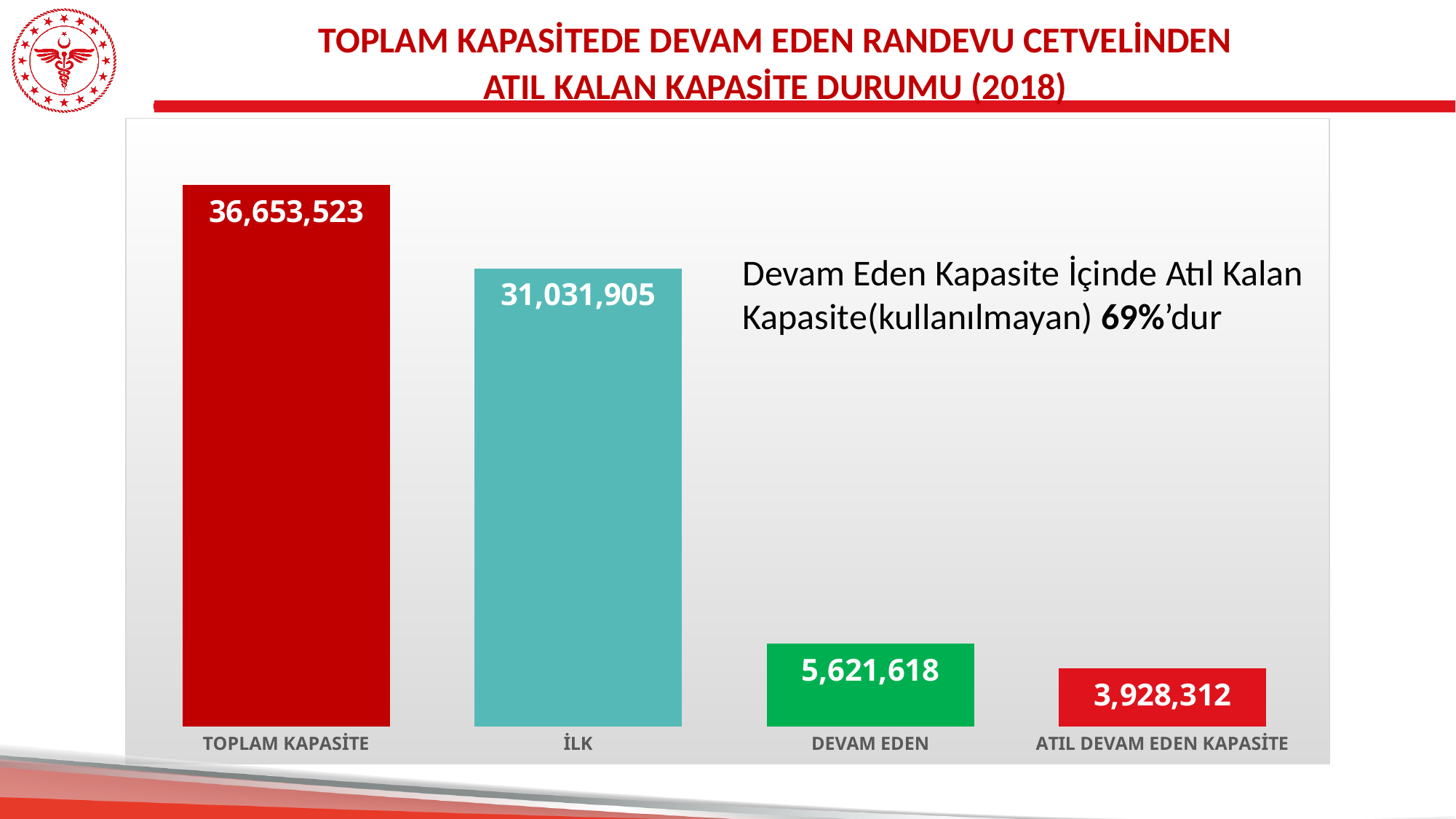
What is the value for ATIL DEVAM EDEN KAPASİTE? 3,928,312 Which category has the highest value? TOPLAM KAPASİTE What colour is the bar for DEVAM EDEN? Green How many categories are shown in the chart? 4 What is the value for TOPLAM KAPASİTE? 36,653,523 What is the value for İLK? 31,031,905 What is the difference between TOPLAM KAPASİTE and İLK? 5,621,618 Which category has the lowest value? ATIL DEVAM EDEN KAPASİTE Which is larger, İLK or DEVAM EDEN? İLK What is the value for DEVAM EDEN? 5,621,618 What is the difference between DEVAM EDEN and ATIL DEVAM EDEN KAPASİTE? 1,693,306 What kind of chart is shown on the slide? Bar chart